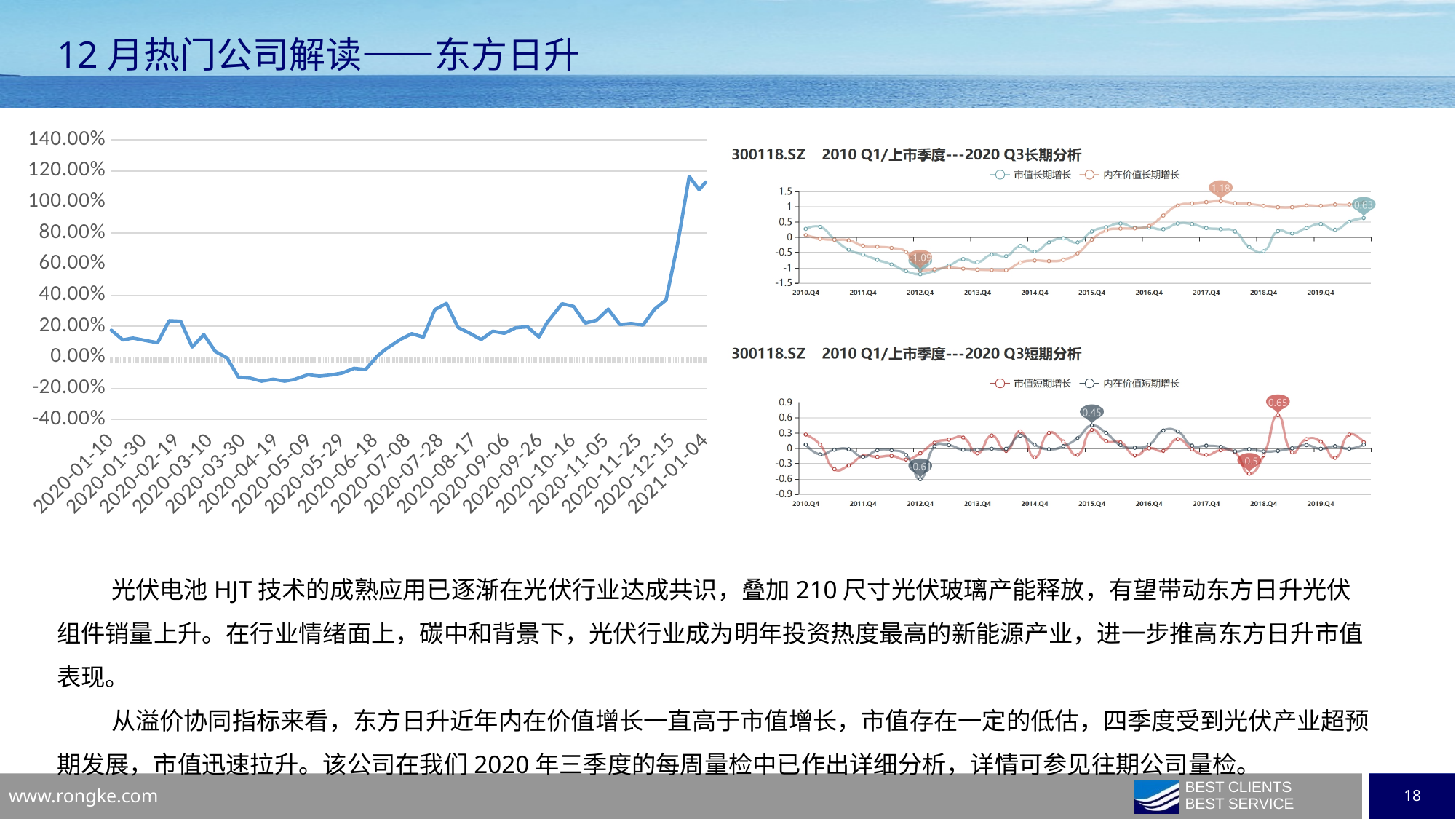
In the chart titled '300118.SZ 2010 Q1/上市季度---2020 Q3长期分析', what is the highest labelled value of the 内在价值长期增长 series? 1.18 In the large chart on the left, is the value for 2021-01-04 greater or less than 100.00%? greater In the large chart on the left, is the value for 2020-04-19 greater or less than 0.00%? less In the chart titled '300118.SZ 2010 Q1/上市季度---2020 Q3短期分析', which is larger: the labelled peak of 市值短期增长 (0.65) or the labelled peak of 内在价值短期增长 (0.45)? 市值短期增长 (0.65) In the chart titled '300118.SZ 2010 Q1/上市季度---2020 Q3短期分析', what is the highest labelled value of the 市值短期增长 series? 0.65 In the large chart on the left, is the value for 2020-01-10 greater or less than 0.00%? greater What kind of chart is the large chart on the left of the slide? line chart How many series does the legend list in the chart titled '300118.SZ 2010 Q1/上市季度---2020 Q3长期分析'? 2 In the large chart on the left, is the value at the end of the series (2021-01-04) higher or lower than at the start (2020-01-10)? higher In the chart titled '300118.SZ 2010 Q1/上市季度---2020 Q3长期分析', what is the labelled value at the end of the 市值长期增长 series? 0.63 In the chart titled '300118.SZ 2010 Q1/上市季度---2020 Q3短期分析', what is the lowest labelled value of the 内在价值短期增长 series? -0.61 In the chart titled '300118.SZ 2010 Q1/上市季度---2020 Q3长期分析', what is the lowest labelled value shown? -1.09